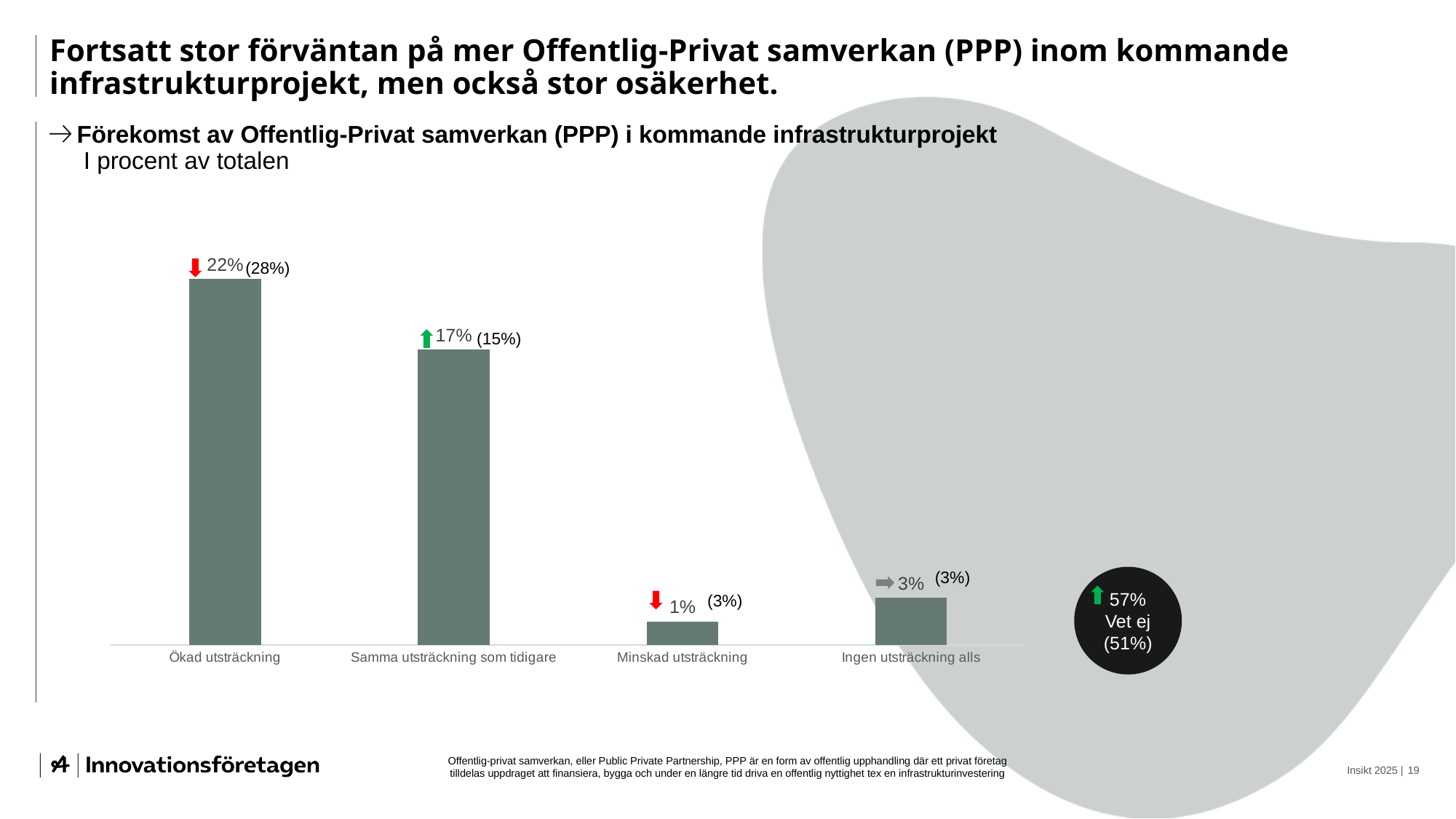
What percentage is shown in the "Vet ej" circle next to the chart? 57% What is the difference between the values for "Ökad utsträckning" and "Samma utsträckning som tidigare"? 5 percentage points What is the value for "Minskad utsträckning"? 1% Which category has the highest value? Ökad utsträckning What is the previous-year value shown in parentheses for "Ökad utsträckning"? 28% What is the value for "Ökad utsträckning"? 22% What is the value for "Samma utsträckning som tidigare"? 17% Which is larger, the value for "Ingen utsträckning alls" or the value for "Minskad utsträckning"? Ingen utsträckning alls What kind of chart is shown on the slide? Bar chart How many categories are shown on the x axis of the bar chart? 4 What is the value for "Ingen utsträckning alls"? 3% Which category has the lowest value? Minskad utsträckning